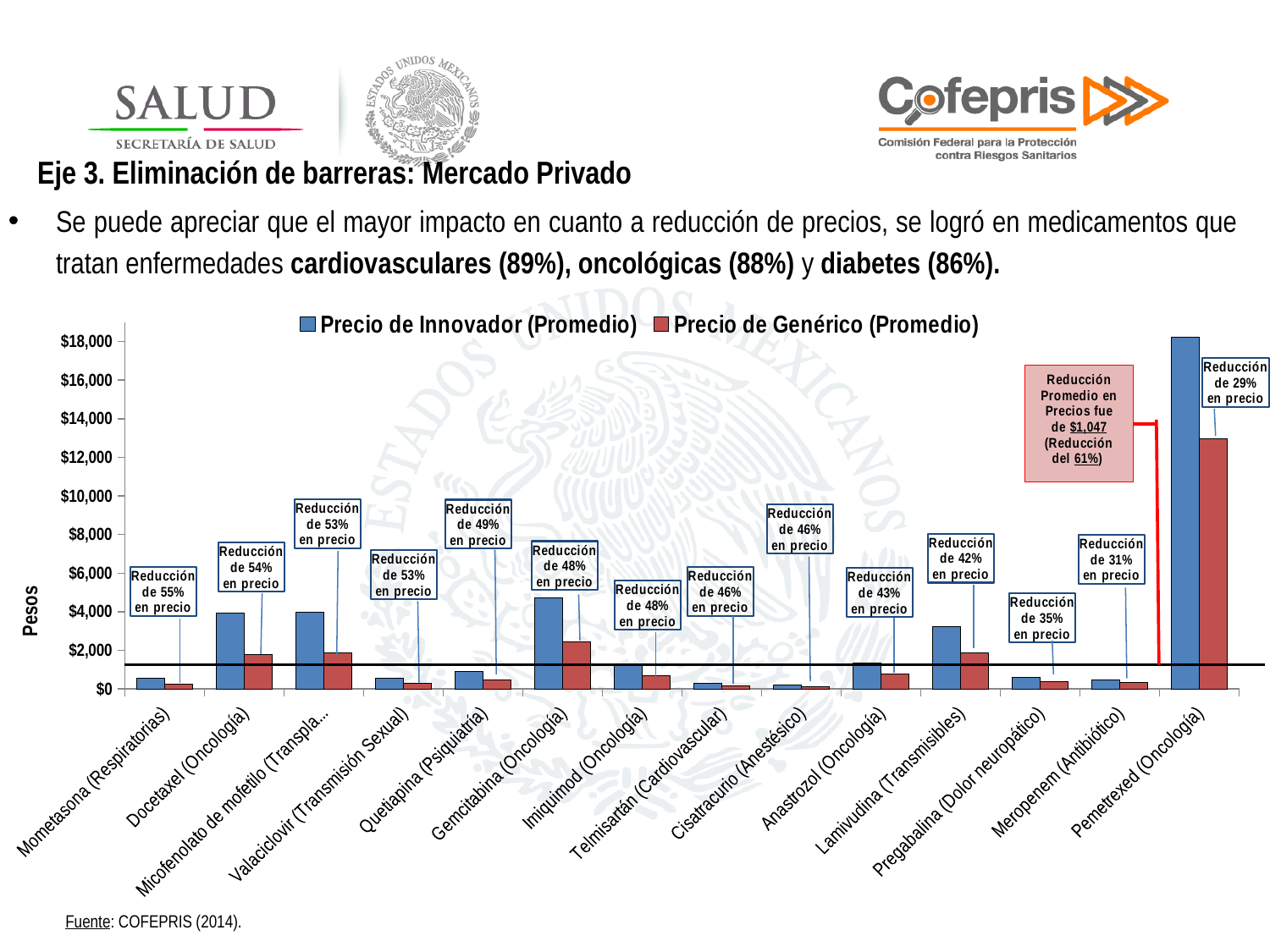
What kind of chart is shown on the slide? Bar chart How many medicine categories are shown on the x axis of the chart? 14 Is the Precio de Innovador (Promedio) for Pemetrexed (Oncología) greater or less than $16,000? greater Is the Precio de Innovador (Promedio) for Gemcitabina (Oncología) greater or less than $4,000? greater What price reduction percentage is annotated for Pemetrexed (Oncología)? 29% How many series does the chart legend list? 2 What price reduction percentage is annotated for Mometasona (Respiratorias)? 55% Which is larger for Docetaxel (Oncología): the Precio de Innovador (Promedio) or the Precio de Genérico (Promedio)? Precio de Innovador (Promedio) What is the label of the vertical axis of the chart? Pesos Which medicine has the highest Precio de Innovador (Promedio)? Pemetrexed (Oncología) According to the red box on the chart, what was the average price reduction in pesos? $1,047 Is the Precio de Genérico (Promedio) for Pemetrexed (Oncología) greater or less than $14,000? less